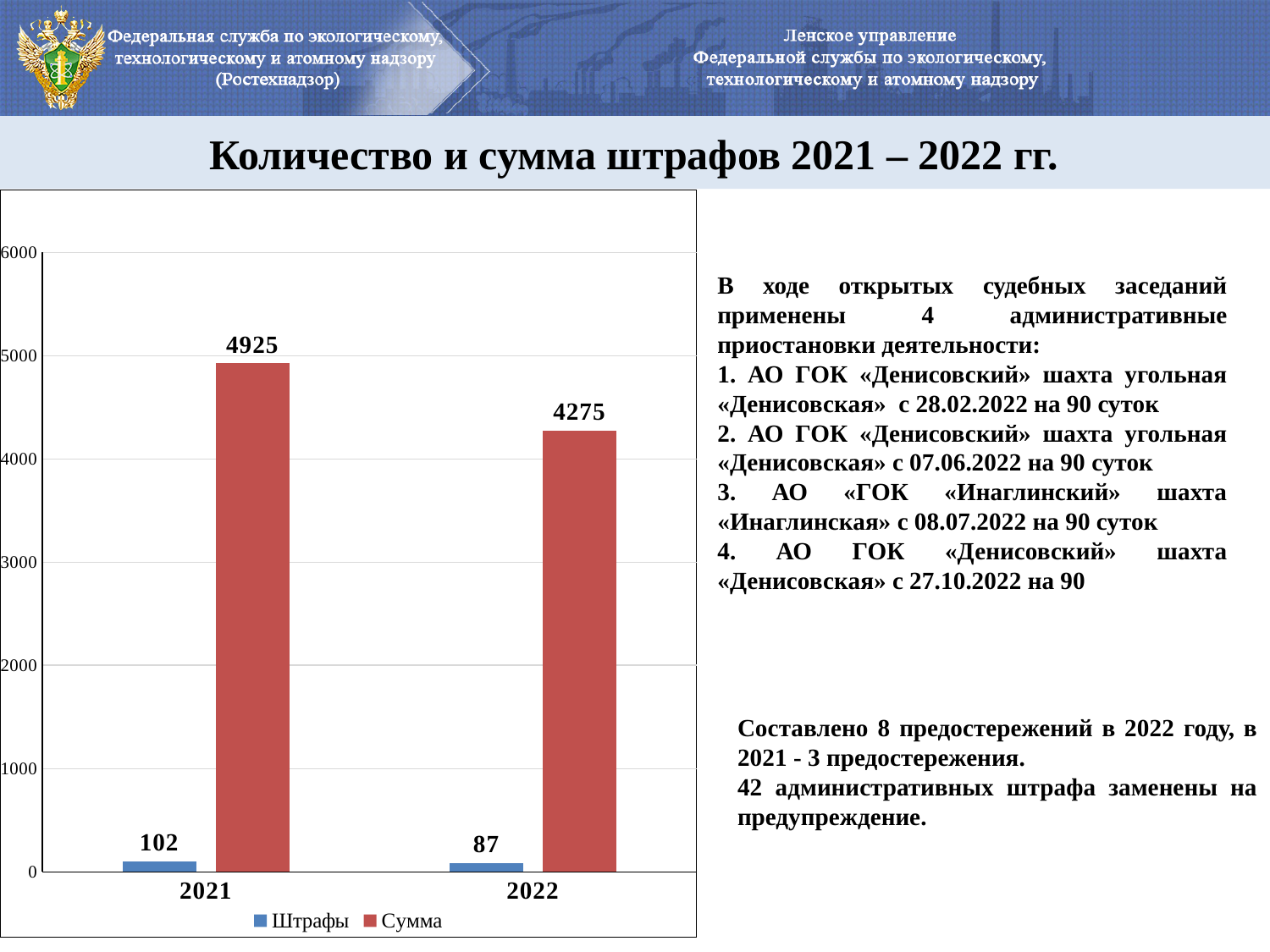
What kind of chart is shown on the slide? bar chart What is the difference between the Штрафы values for 2021 and 2022? 15 Which year has the higher value for Сумма? 2021 What is the value of Штрафы for 2021? 102 What is the value of Сумма for 2021? 4925 How many series does the legend list? 2 What is the value of Сумма for 2022? 4275 What is the value of Штрафы for 2022? 87 Is the Сумма value for 2022 greater or less than 4000? greater Which year has the lower value for Штрафы? 2022 What is the difference between the Сумма values for 2021 and 2022? 650 Does the Сумма series rise or fall from 2021 to 2022? fall